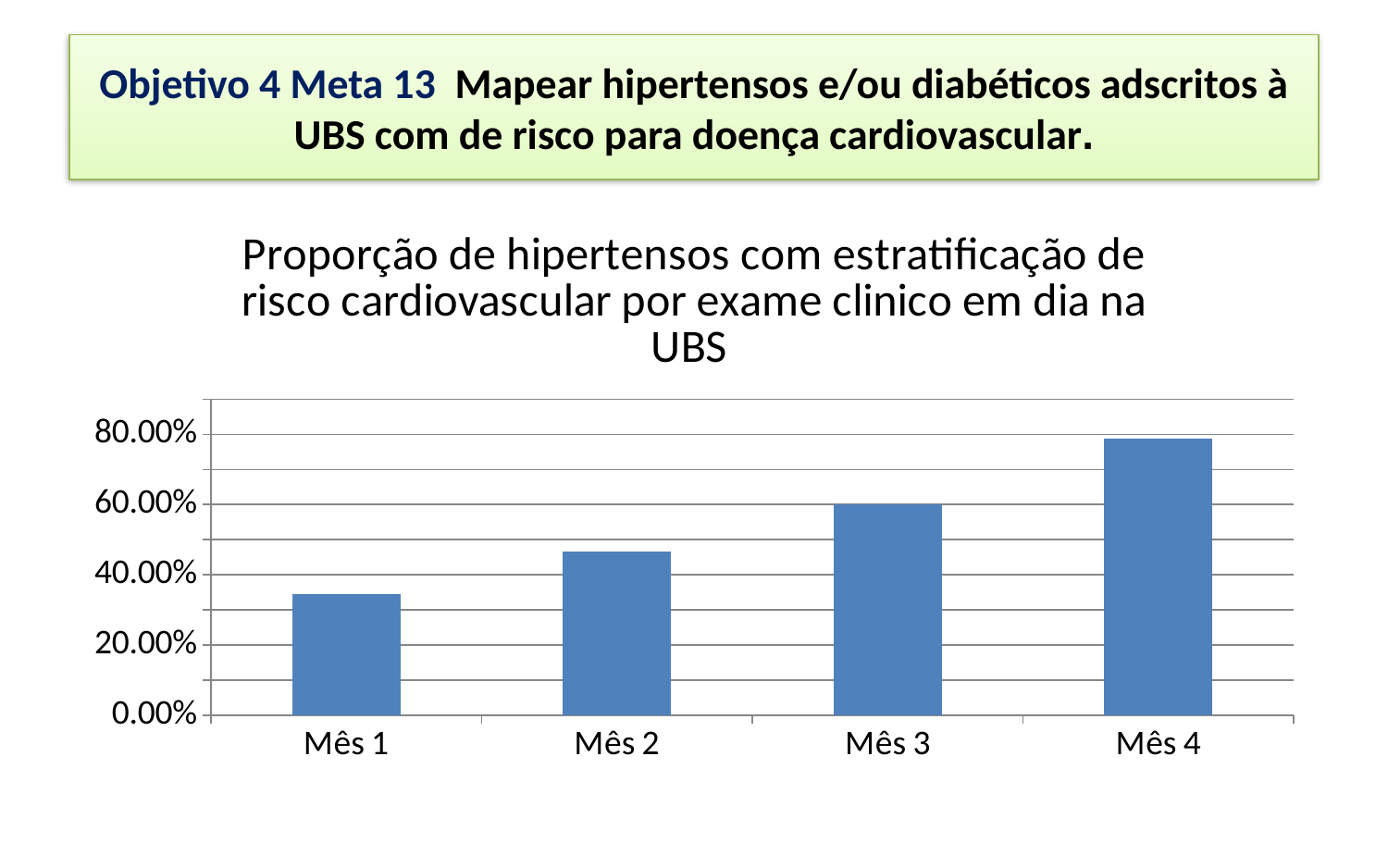
Which month has the highest proportion of hypertensive patients with cardiovascular risk stratification? Mês 4 What is the title of the chart? Proporção de hipertensos com estratificação de risco cardiovascular por exame clinico em dia na UBS How many months (categories) are plotted on the chart? 4 Is the value for Mês 2 greater or less than 40.00%? greater Which month has the lowest proportion of hypertensive patients with cardiovascular risk stratification? Mês 1 Is the value for Mês 1 greater or less than 40.00%? less Which is larger, the value for Mês 1 or the value for Mês 4? Mês 4 Which is larger, the value for Mês 2 or the value for Mês 3? Mês 3 Is the value for Mês 1 greater or less than 20.00%? greater Do the values rise or fall from Mês 1 to Mês 4? rise What kind of chart is shown on the slide? bar chart